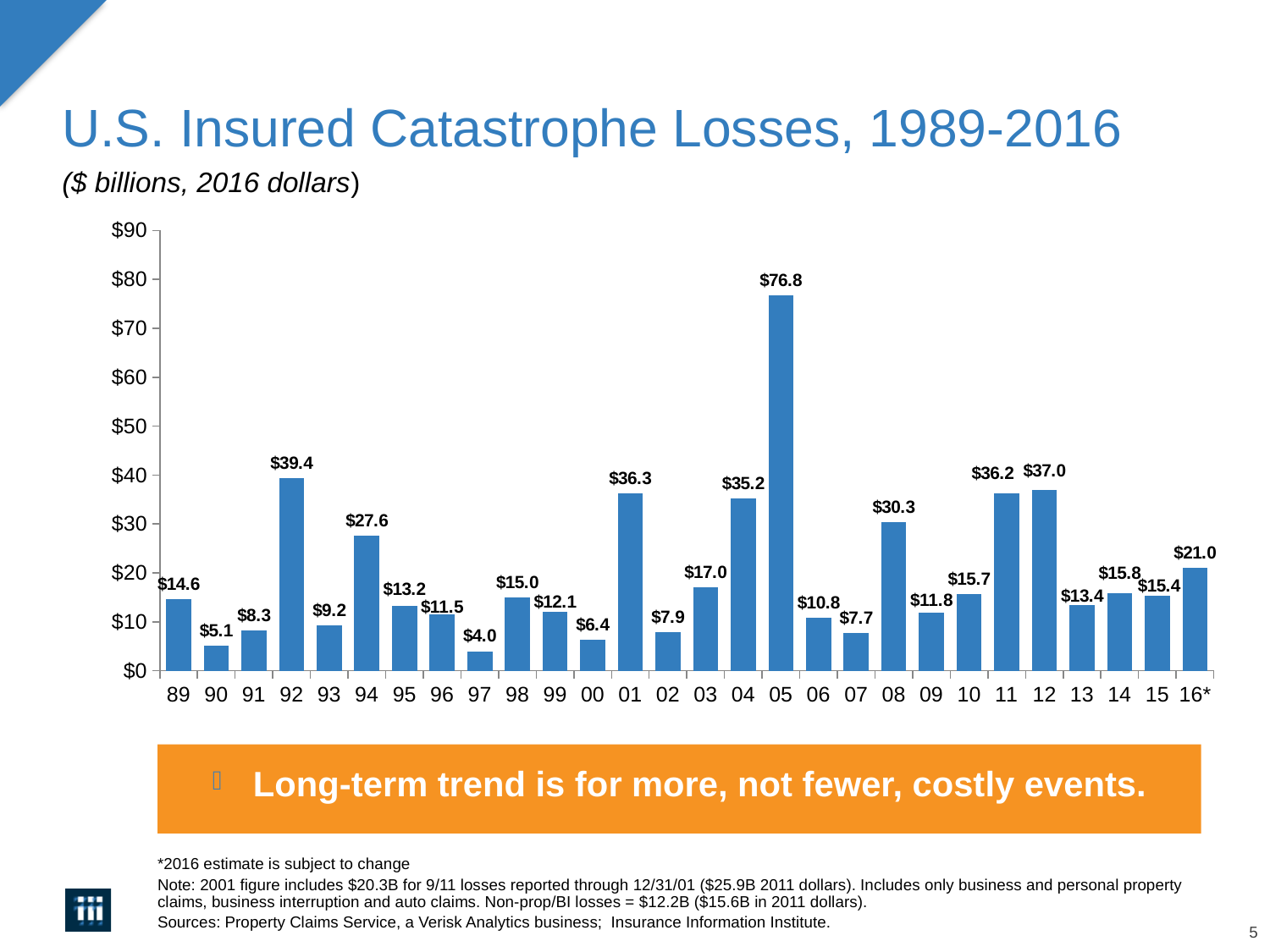
What is the difference between the values for 2005 and 2004? $41.6 What is the value for 2016 (16*)? $21.0 Which year has the lowest insured catastrophe losses? 97 Which is larger, the value for 2011 or the value for 2012? 2012 What is the value for 1992 (92)? $39.4 What kind of chart is this? Bar chart Which year has the highest insured catastrophe losses? 05 What unit is stated in the chart subtitle? $ billions, 2016 dollars What is the value for 2005 (05)? $76.8 What is the difference between the values for 2001 and 2000? $29.9 How many years are shown on the x axis? 28 Is the value for 2008 greater or less than $20? greater